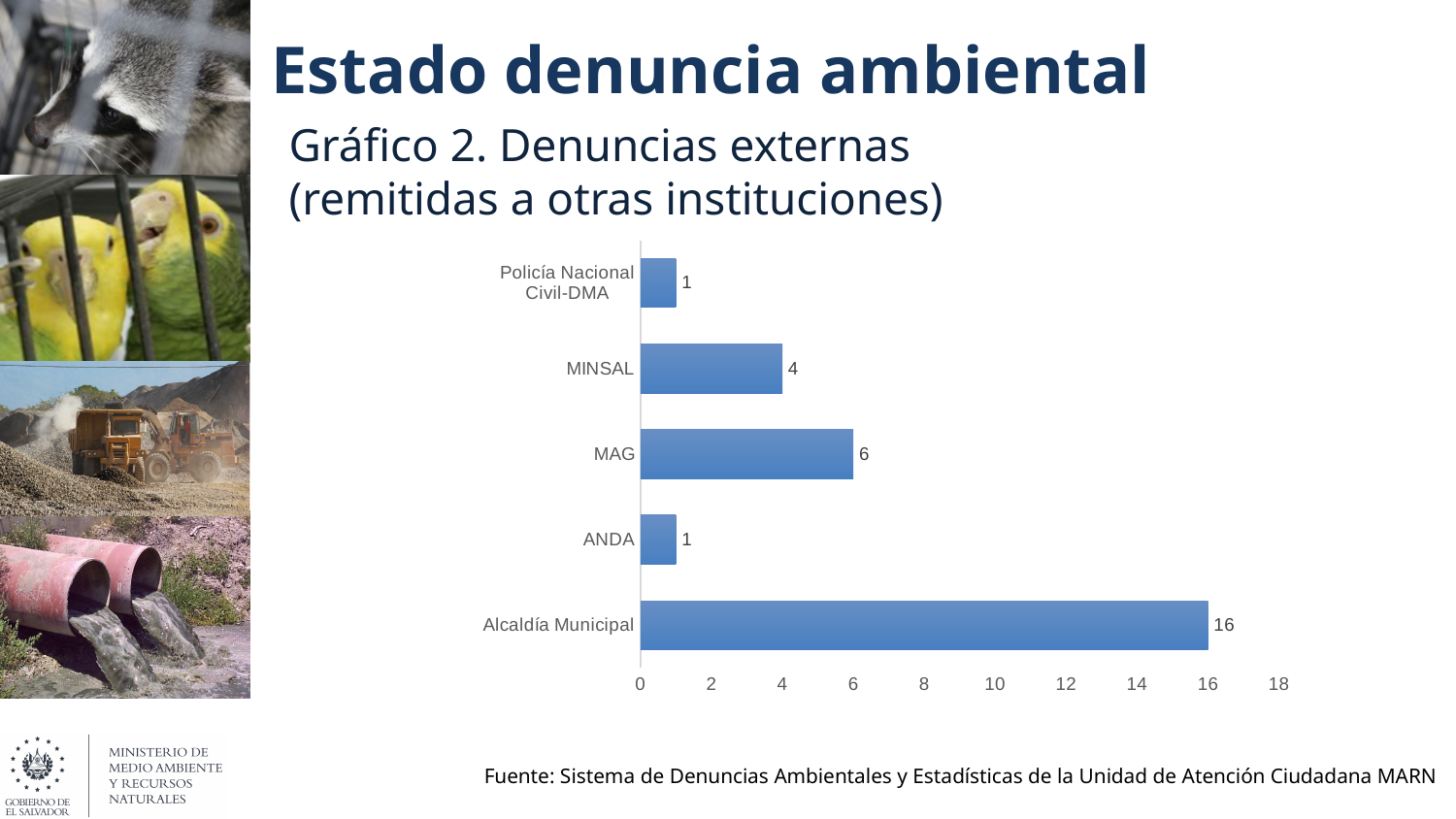
How many categories are shown in the chart? 5 What is the value for MINSAL? 4 Which category has the highest value? Alcaldía Municipal What kind of chart is shown on the slide? bar chart What is the value for MAG? 6 What is the difference between the values for Alcaldía Municipal and MAG? 10 Is the value for Alcaldía Municipal greater or less than 10? greater Which is larger, the value for MINSAL or the value for MAG? MAG What is the title of the chart? Gráfico 2. Denuncias externas (remitidas a otras instituciones) What is the value for ANDA? 1 What is the value for Alcaldía Municipal? 16 What is the difference between the values for MAG and MINSAL? 2